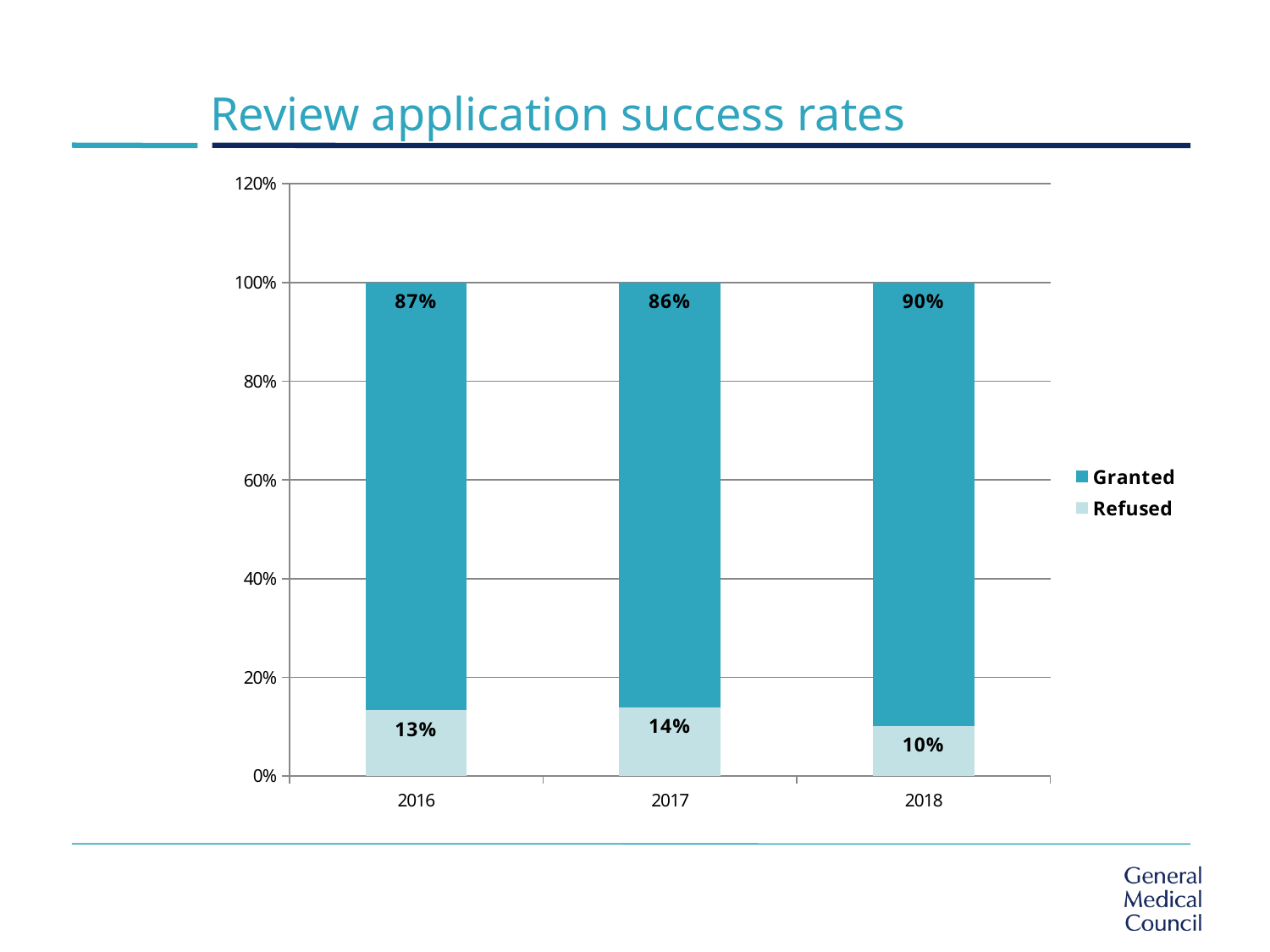
What kind of chart is shown on the slide? Stacked bar chart Is the Refused percentage larger in 2016 or in 2018? 2016 Which year has the lowest Refused percentage? 2018 What percentage of review applications were granted in 2016? 87% How many series does the legend list? 2 What is the Granted value for 2018? 90% What percentage of review applications were refused in 2017? 14% What is the title of the chart? Review application success rates Which year has the highest Granted percentage? 2018 How many years are shown on the x axis? 3 What is the difference between the Granted percentages for 2018 and 2017? 4% What is the total of the stacked bar for 2017? 100%